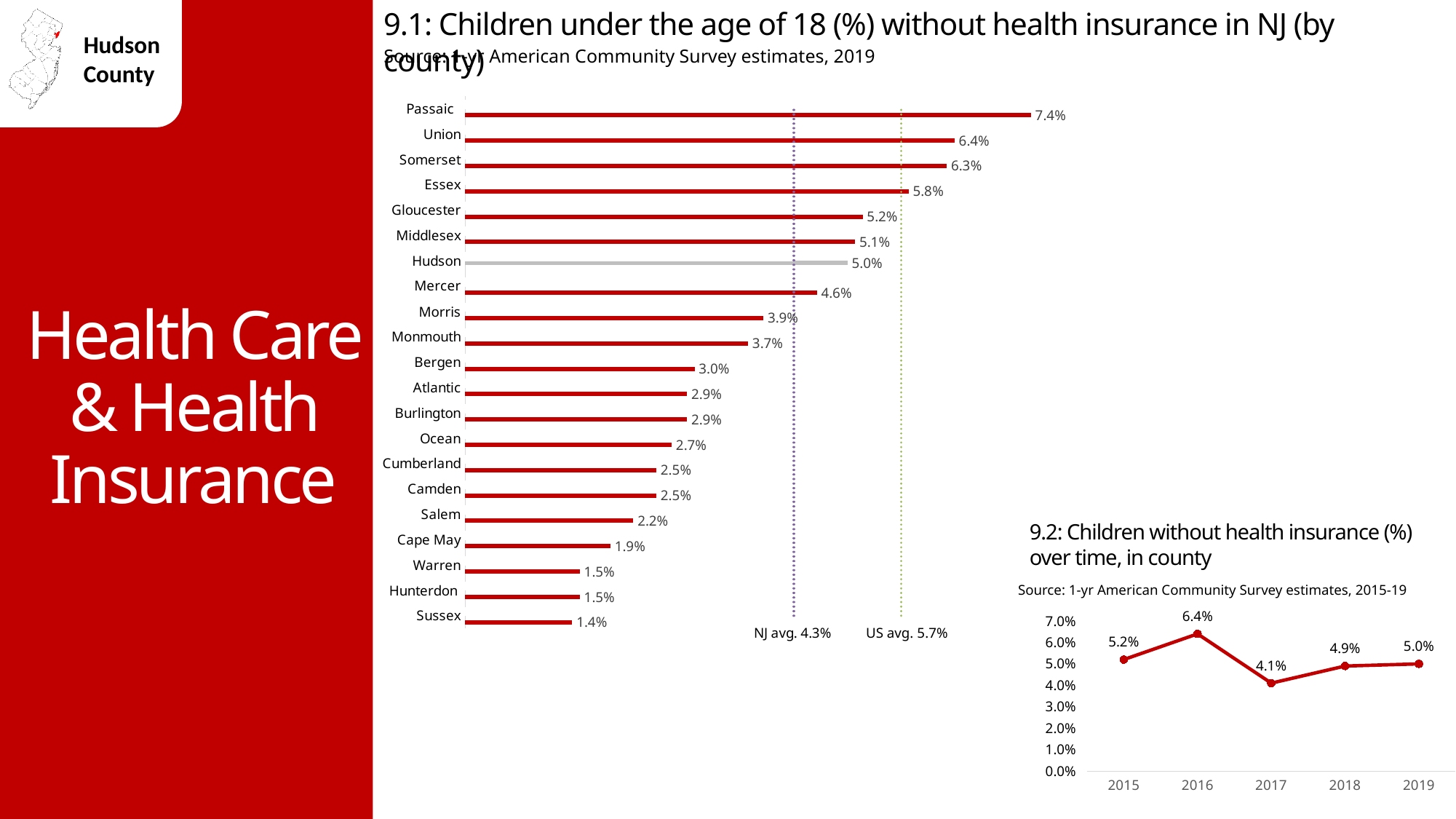
In chart 9.2 (children without health insurance over time), which year has the highest value? 2016 In chart 9.1 (children without health insurance by county), which county has the highest value? Passaic In chart 9.1 (children without health insurance by county), which is larger, the value for Essex or the value for Mercer? Essex In chart 9.1 (children without health insurance by county), what is the value for Hudson? 5.0% In chart 9.1 (children without health insurance by county), which county has the lowest value? Sussex In chart 9.1 (children without health insurance by county), how many counties are plotted? 21 In chart 9.1 (children without health insurance by county), what is the difference between Passaic and Hudson? 2.4% What kind of chart is chart 9.2 (children without health insurance over time)? Line chart What kind of chart is chart 9.1 (children without health insurance by county)? Bar chart In chart 9.1 (children without health insurance by county), what is the NJ average shown by the dotted line? 4.3% In chart 9.2 (children without health insurance over time), what is the value for 2017? 4.1% In chart 9.2 (children without health insurance over time), what is the difference between 2016 and 2017? 2.3%